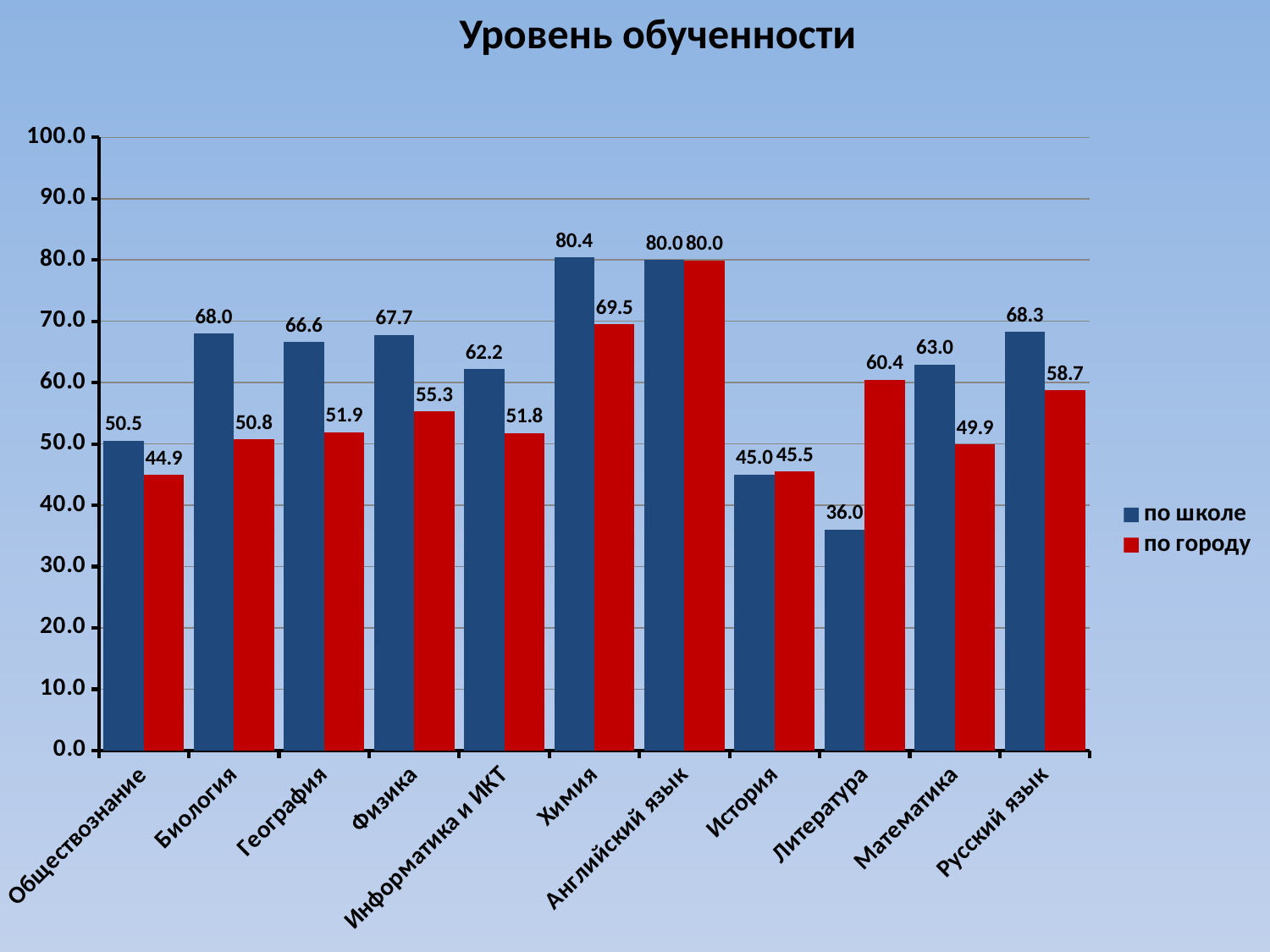
What is the value for Биология in the по школе series? 68.0 What is the value for Математика in the по городу series? 49.9 Which category has the lowest value in the по городу series? Обществознание How many categories are shown on the x axis? 11 Which is larger for Физика: the по школе value or the по городу value? по школе Which category has the lowest value in the по школе series? Литература Which category has the highest value in the по школе series? Химия What is the difference between the по городу and по школе values for Литература? 24.4 Is the по школе value for Информатика и ИКТ greater or less than 60.0? greater What kind of chart is shown on the slide? bar chart What is the value for Литература in the по городу series? 60.4 How many series does the legend list? 2